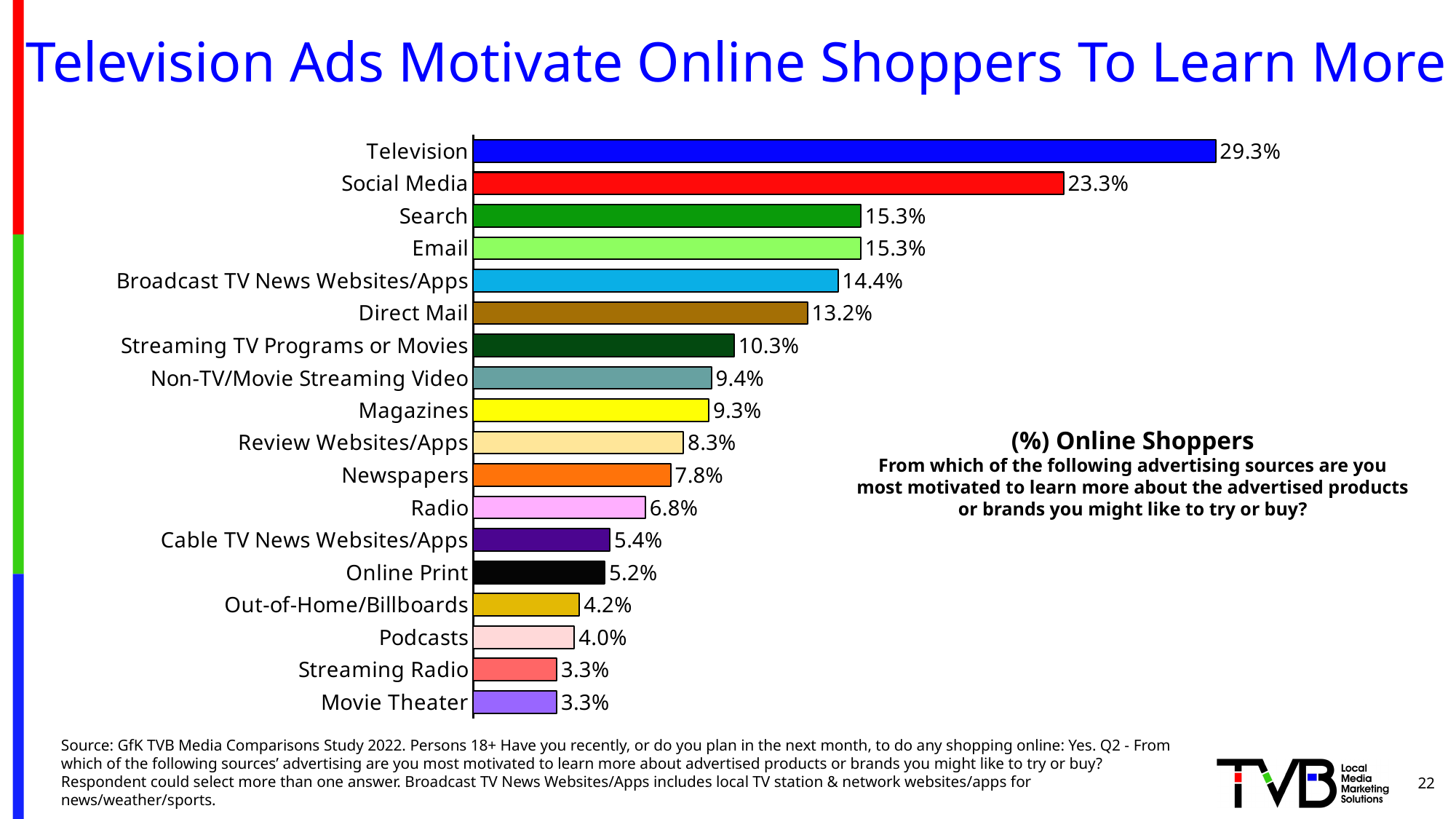
What percentage of online shoppers are most motivated by Television ads to learn more? 29.3% What kind of chart is shown on the slide? Bar chart Which advertising source has the highest percentage of online shoppers? Television Which is larger, the value for Magazines or the value for Newspapers? Magazines What is the difference between the Search and Radio values? 8.5% What is the difference between the Television and Social Media values? 6.0% How many advertising sources are shown in the chart? 18 Do the values rise or fall going from the top bar to the bottom bar? Fall What is the value shown for Direct Mail? 13.2% Which is larger, the value for Broadcast TV News Websites/Apps or the value for Cable TV News Websites/Apps? Broadcast TV News Websites/Apps What colour is the Television bar? Blue What is the value shown for Podcasts? 4.0%